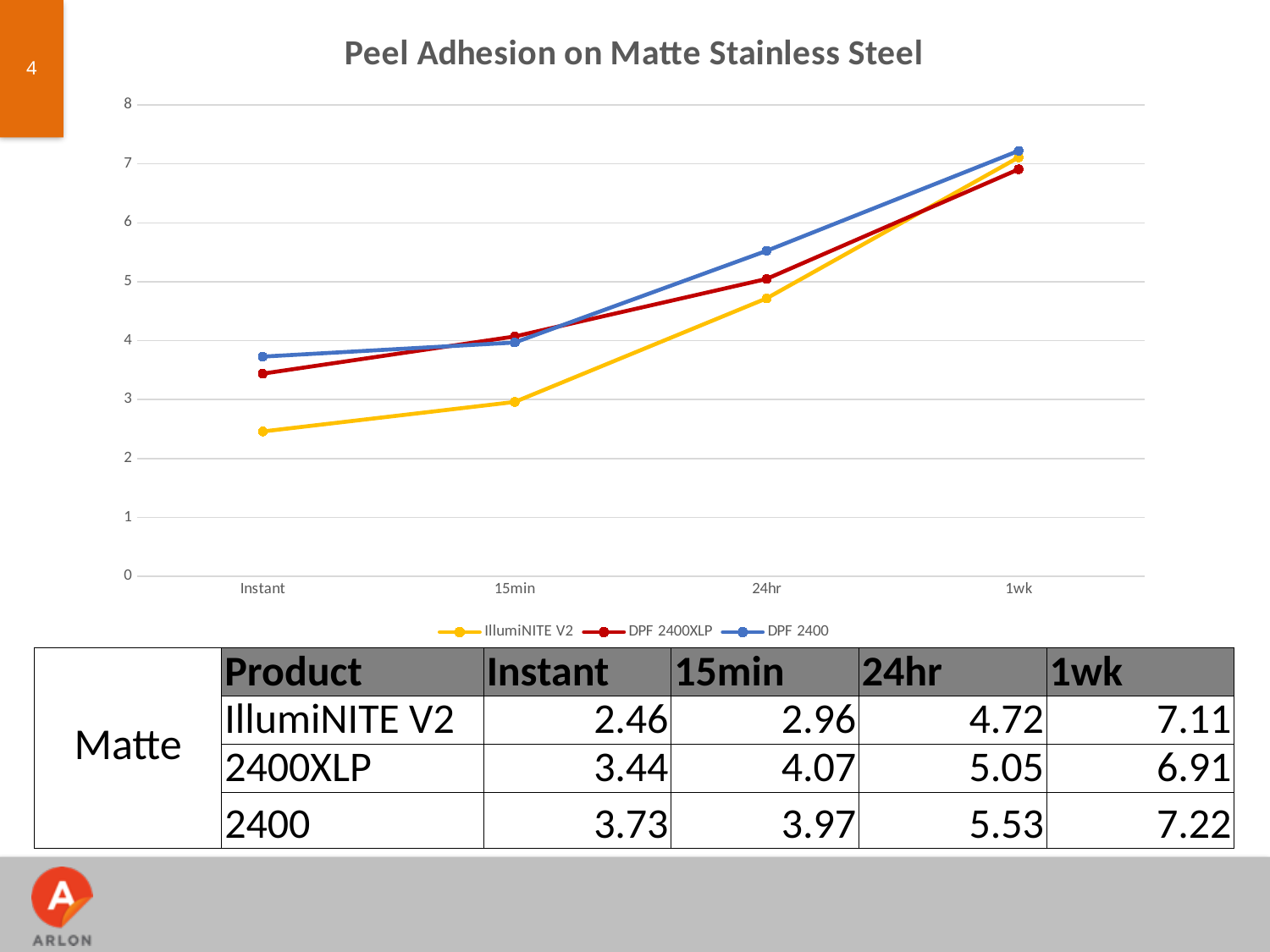
What kind of chart is shown on the slide? line chart What is the peel adhesion value for DPF 2400 at 24hr? 5.53 Which series has the lowest value at Instant? IllumiNITE V2 At 15min, which is larger: the value for DPF 2400XLP or the value for IllumiNITE V2? DPF 2400XLP What is the difference between the DPF 2400 and IllumiNITE V2 values at 24hr? 0.81 What is the peel adhesion value for IllumiNITE V2 at Instant? 2.46 What is the title of the chart? Peel Adhesion on Matte Stainless Steel How many series does the chart legend list? 3 Which series has the highest value at 24hr? DPF 2400 Do the IllumiNITE V2 values rise or fall from Instant to 1wk? rise What is the peel adhesion value for DPF 2400XLP at 1wk? 6.91 How many time points are plotted along the x axis? 4